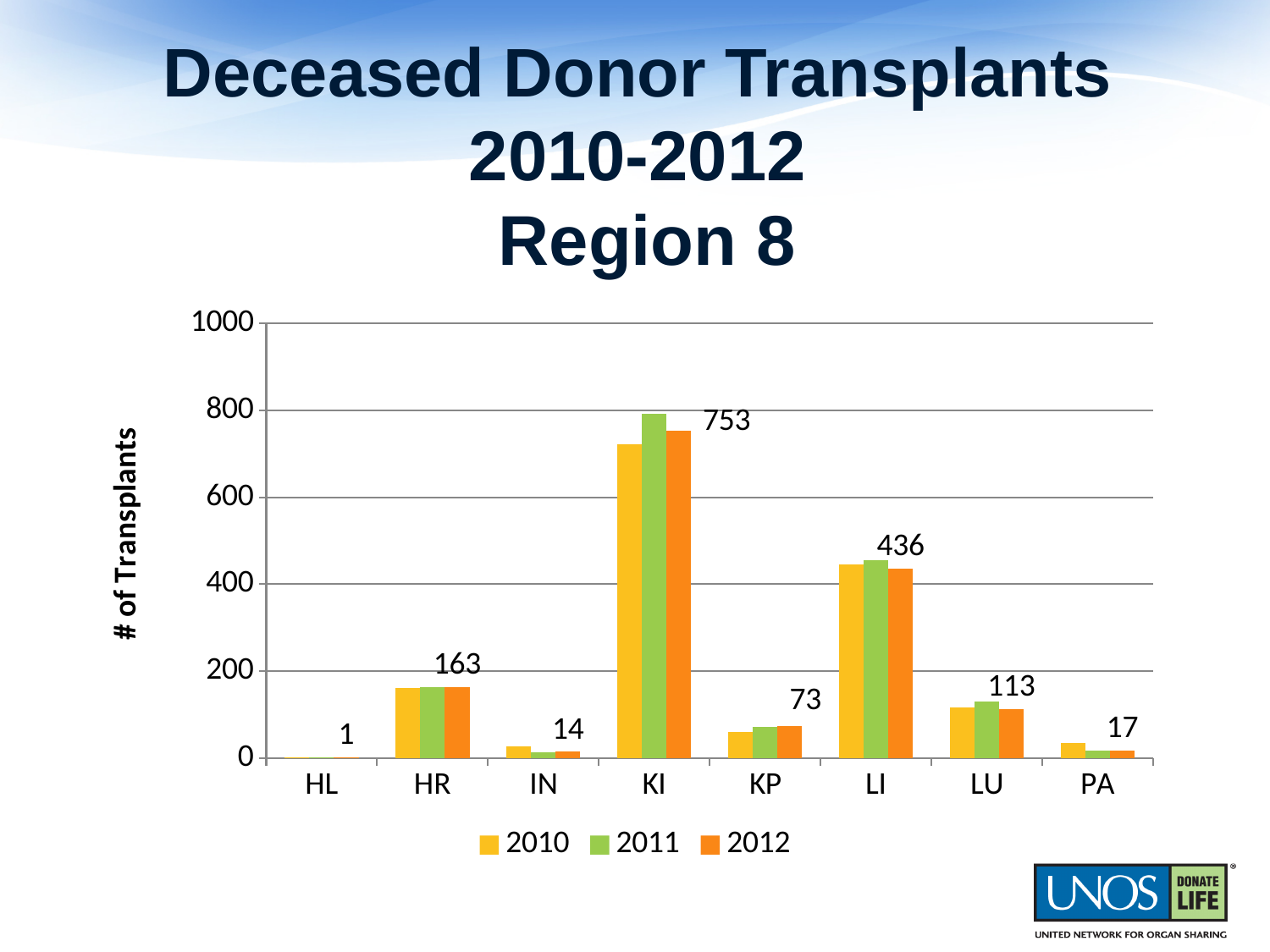
What is the value for PA in 2012? 17 What kind of chart is shown on the slide? bar chart What is the value for LI in 2012? 436 Which organ category has the lowest number of transplants in 2012? HL Which organ category has the highest number of transplants in 2012? KI What is the difference between the 2012 values for KI and LI? 317 How many organ categories are shown on the x axis? 8 What is the value for HR in 2012? 163 Which is larger in 2012, the value for KP or the value for LU? LU Is the value for KI in 2011 greater or less than 600? greater How many series does the legend list? 3 What is the value for KI in 2012? 753